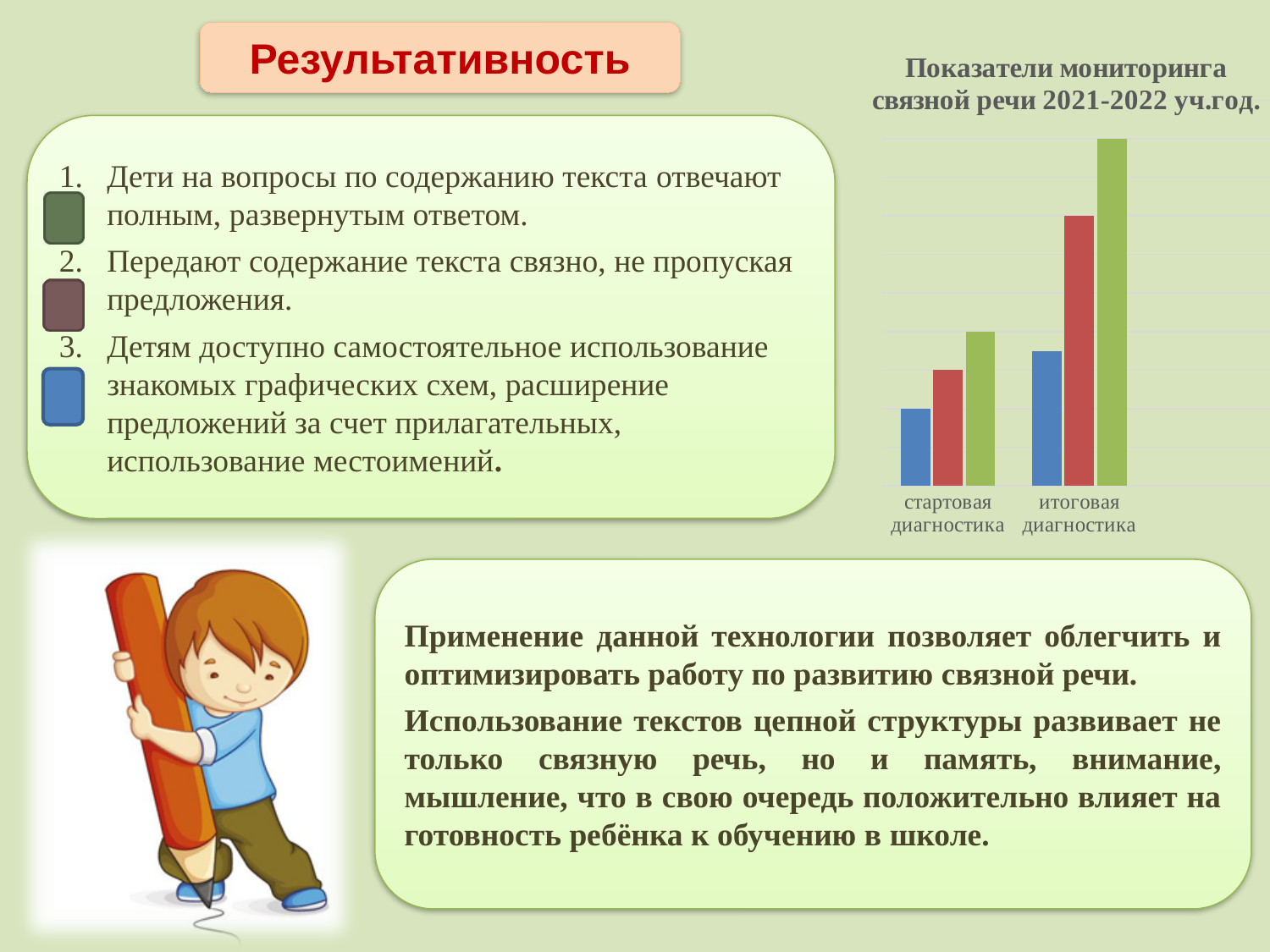
Does the chart include a legend? no Which category has the shortest bar in the chart? стартовая диагностика What is the title of the chart? Показатели мониторинга связной речи 2021-2022 уч.год. Within итоговая диагностика, which coloured bar is the tallest? green Is the blue bar larger for стартовая диагностика or for итоговая диагностика? итоговая диагностика Is the green bar larger for стартовая диагностика or for итоговая диагностика? итоговая диагностика How many categories are shown on the x axis of the chart? 2 Do the bar values rise or fall from стартовая диагностика to итоговая диагностика? rise Within стартовая диагностика, which coloured bar is the shortest? blue How many bars are plotted for each category in the chart? 3 Which category has the tallest bar in the chart? итоговая диагностика What kind of chart is shown on the slide? bar chart